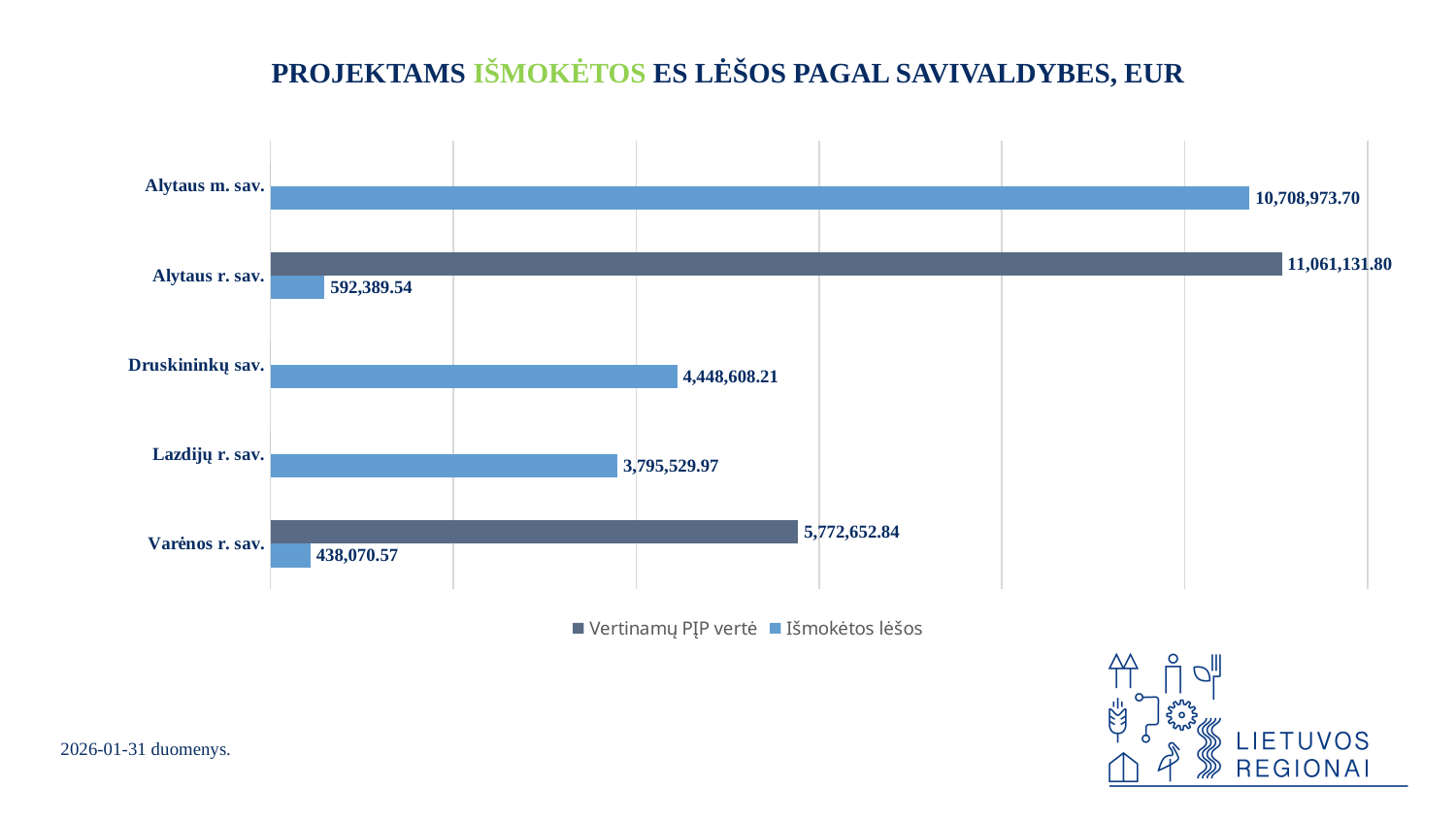
How many municipalities are shown on the chart? 5 How many series does the legend list? 2 Which municipality has the lowest Išmokėtos lėšos value? Varėnos r. sav. What is the difference between the Vertinamų PĮP vertė and Išmokėtos lėšos values for Alytaus r. sav.? 10,468,742.26 What is the Vertinamų PĮP vertė value for Varėnos r. sav.? 5,772,652.84 Which is larger: the Išmokėtos lėšos value for Lazdijų r. sav. or for Alytaus r. sav.? Lazdijų r. sav. Which municipality has the highest Išmokėtos lėšos value? Alytaus m. sav. What is the Išmokėtos lėšos value for Alytaus m. sav.? 10,708,973.70 What kind of chart is shown on the slide? Bar chart What is the Vertinamų PĮP vertė value for Alytaus r. sav.? 11,061,131.80 What is the difference between the Išmokėtos lėšos values for Druskininkų sav. and Lazdijų r. sav.? 653,078.24 What is the Išmokėtos lėšos value for Druskininkų sav.? 4,448,608.21